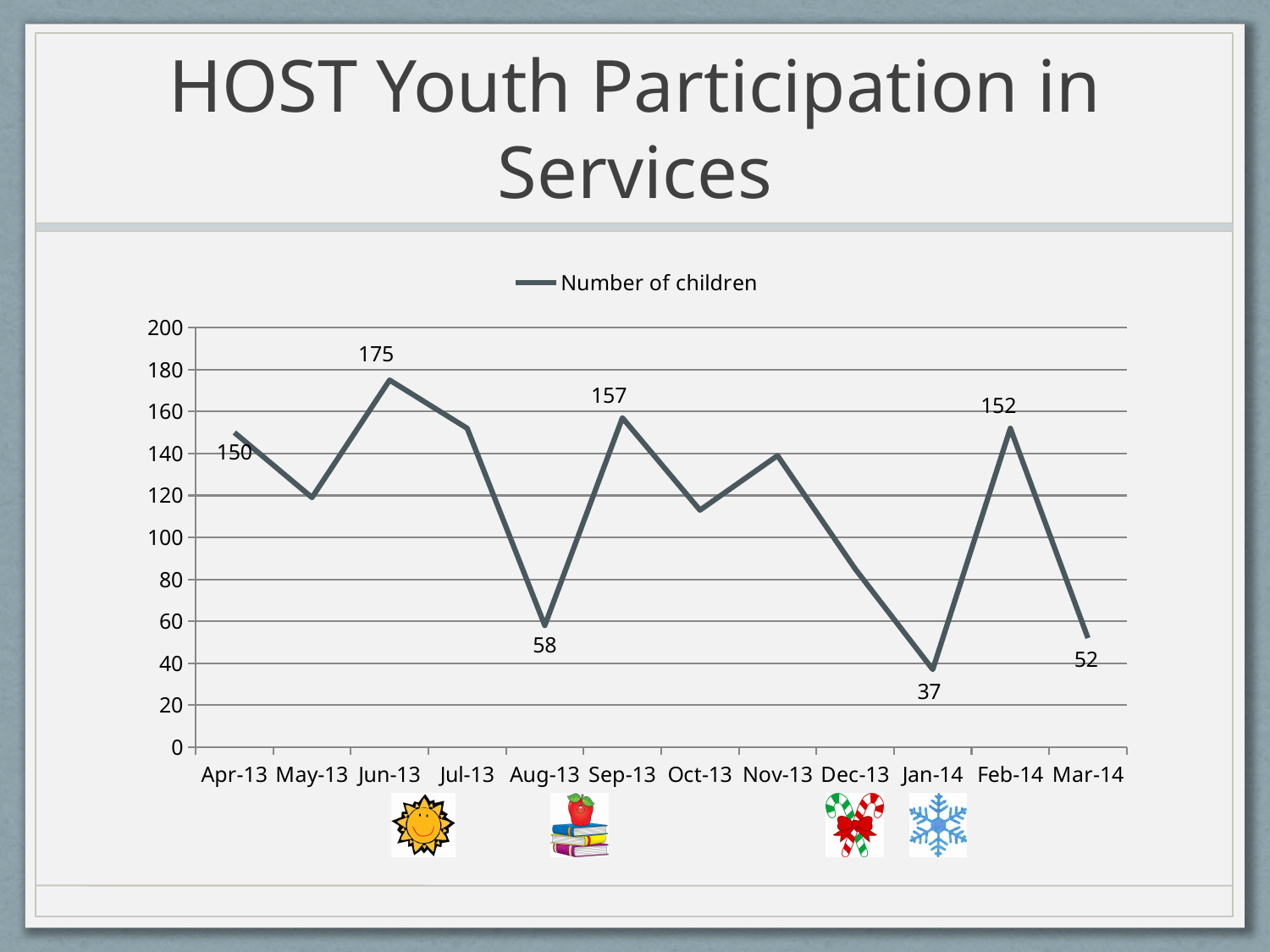
Which month has more children, Feb-14 or Mar-14? Feb-14 Which month has the highest number of children? Jun-13 What is the number of children for Sep-13? 157 Is the value for Nov-13 greater or less than 120? greater What is the title of the slide? HOST Youth Participation in Services Is the value for Dec-13 greater or less than 100? less What is the number of children for Jan-14? 37 What kind of chart is shown on the slide? Line chart Which month has the lowest number of children? Jan-14 What is the difference between the number of children in Jun-13 and Jan-14? 138 What is the number of children for Jun-13? 175 How many months are plotted on the chart? 12